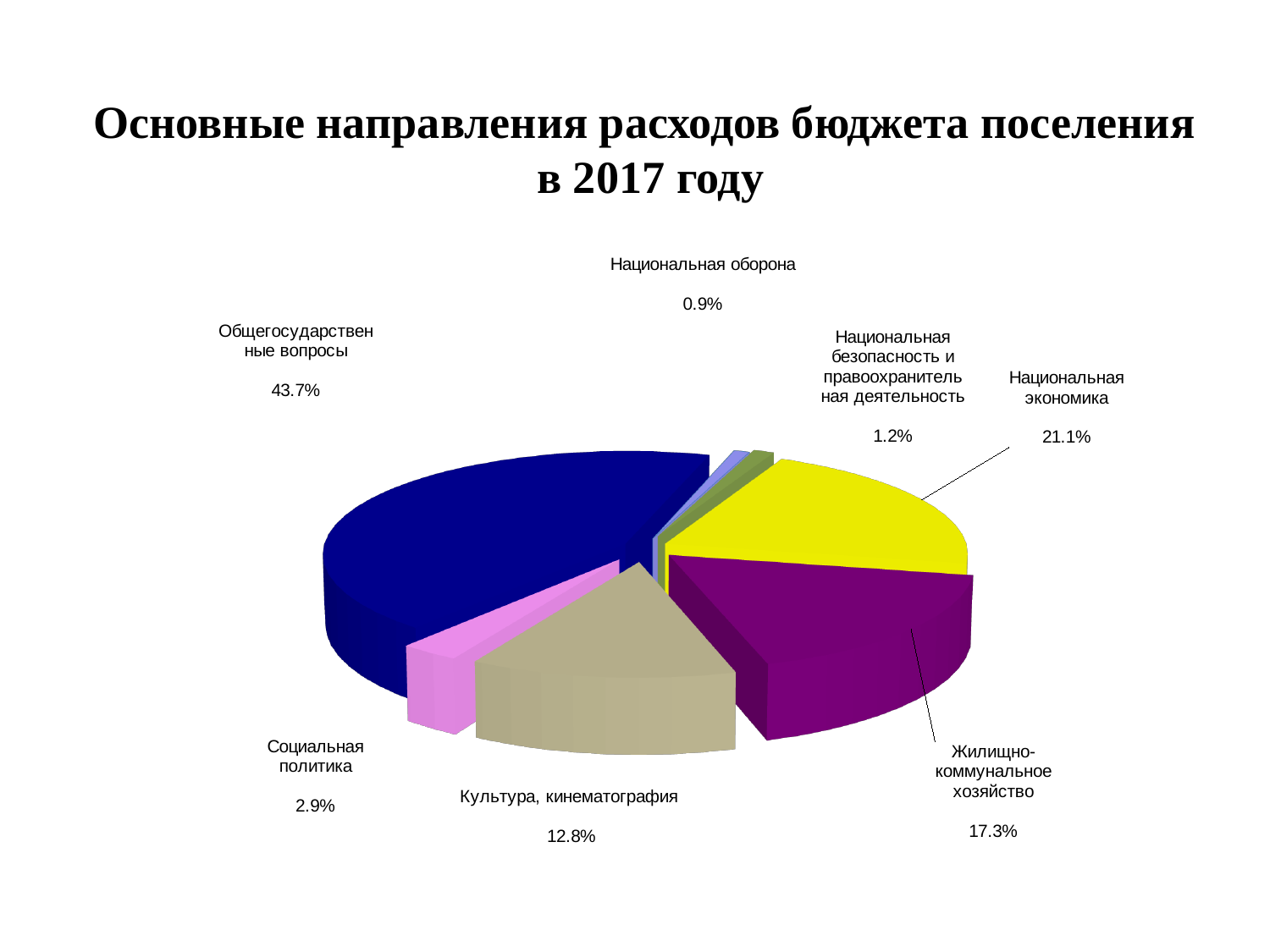
What is the difference between the shares of Национальная экономика and Жилищно-коммунальное хозяйство? 3.8% What type of chart is shown on the slide? Pie chart What is the share for Культура, кинематография? 12.8% Which category has the smallest share of the pie? Национальная оборона What is the share for Национальная экономика? 21.1% How many categories (slices) does the pie chart have? 7 Which is larger: the share for Социальная политика or the share for Национальная безопасность и правоохранительная деятельность? Социальная политика What is the share for Жилищно-коммунальное хозяйство? 17.3% What is the title of the slide? Основные направления расходов бюджета поселения в 2017 году What is the share for Общегосударственные вопросы? 43.7% Which category has the largest share of the pie? Общегосударственные вопросы What is the share for Национальная оборона? 0.9%